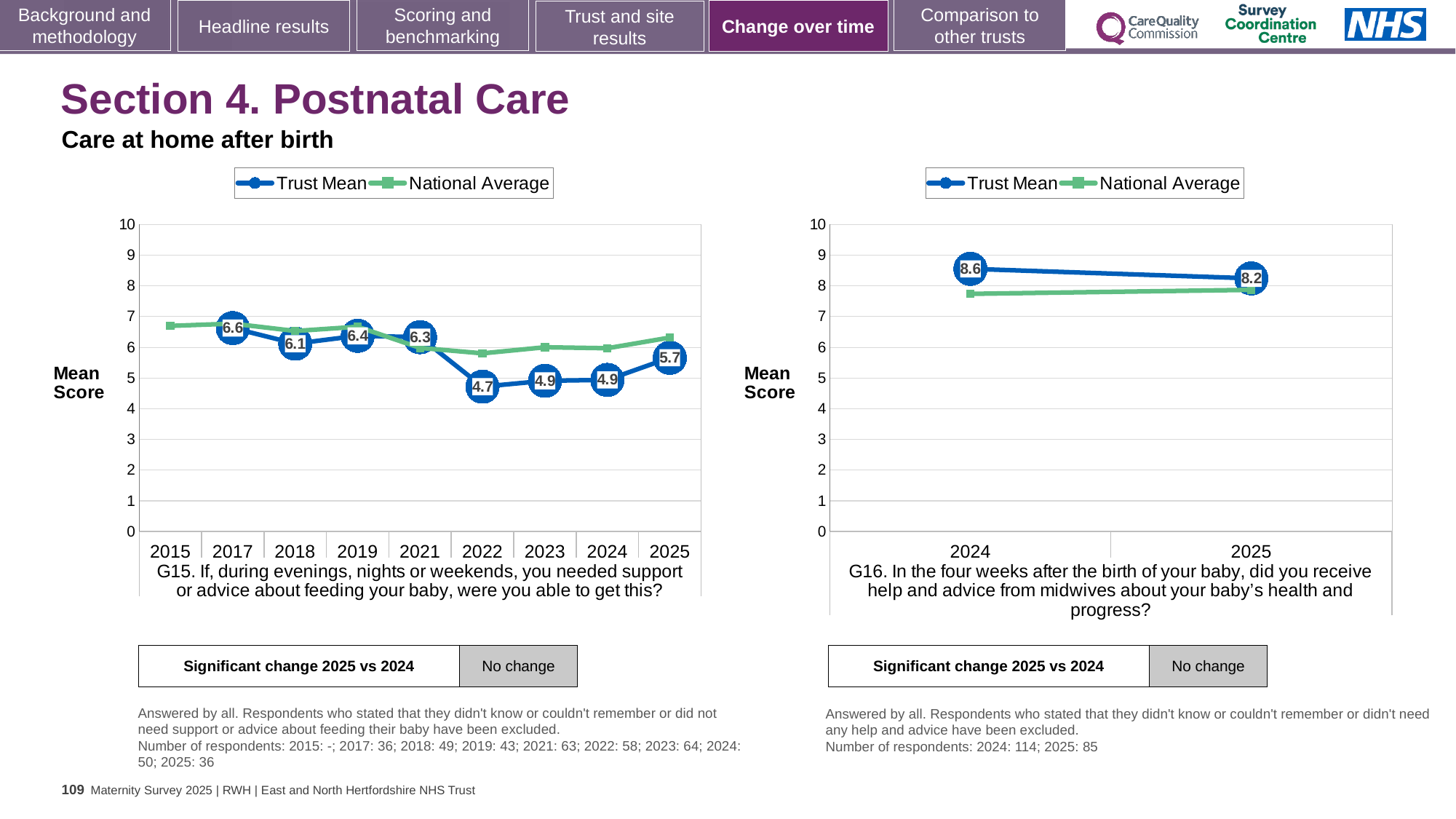
In the G15 chart on the left, is the Trust Mean score for 2018 greater or less than 6? greater In the G16 chart on the right, does the Trust Mean rise or fall from 2024 to 2025? fall In the G16 chart on the right, what is the difference between the Trust Mean scores for 2024 and 2025? 0.4 How many series does the legend of the G16 chart on the right list? 2 In the G15 chart on the left, how many years are shown on the x axis? 9 In the G15 chart on the left, which year has the lowest Trust Mean score? 2022 In the G15 chart on the left, what is the Trust Mean score for 2022? 4.7 In the G15 chart on the left, what is the Trust Mean score for 2025? 5.7 In the G16 chart on the right, what is the Trust Mean score for 2024? 8.6 In the G15 chart on the left, which year has the highest Trust Mean score? 2017 What kind of chart is the G15 chart on the left? line chart In the G15 chart on the left, what is the difference between the Trust Mean scores for 2025 and 2024? 0.8